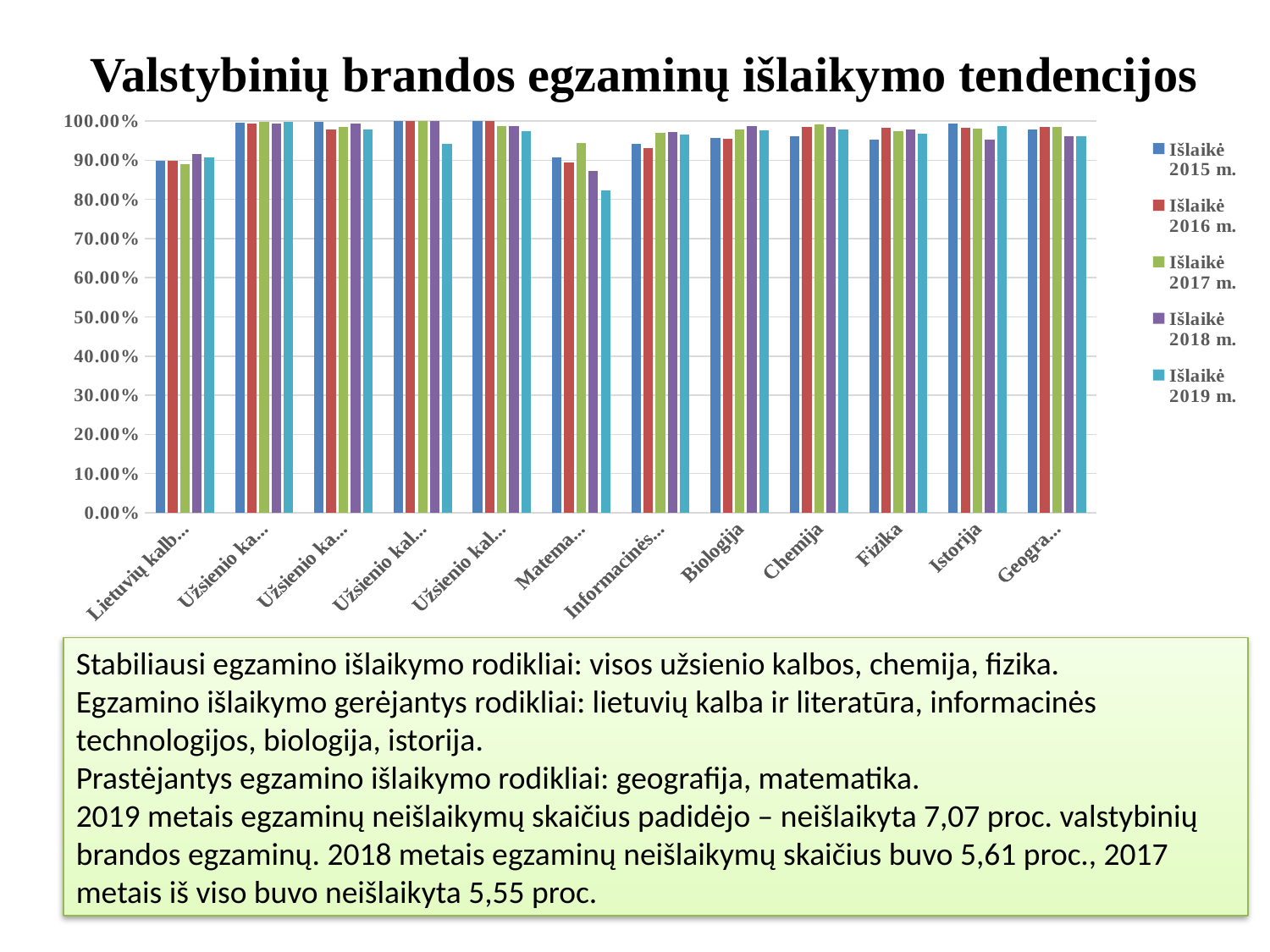
How many series does the legend list? 5 Is the value for Biologija in the Išlaikė 2015 m. series greater or less than 90.00%? greater Is the value for Fizika in the Išlaikė 2019 m. series greater or less than 90.00%? greater For Chemija, which is larger: the Išlaikė 2015 m. value or the Išlaikė 2017 m. value? Išlaikė 2017 m. What is the title of the chart? Valstybinių brandos egzaminų išlaikymo tendencijos For Istorija, which series has the lowest value? Išlaikė 2018 m. Is the value for Istorija in the Išlaikė 2018 m. series greater or less than 80.00%? greater For Istorija, which is larger: the Išlaikė 2015 m. value or the Išlaikė 2018 m. value? Išlaikė 2015 m. What kind of chart is shown on the slide? bar chart Which series is shown in red in the legend? Išlaikė 2016 m. For Fizika, which is larger: the Išlaikė 2015 m. value or the Išlaikė 2016 m. value? Išlaikė 2016 m. How many subject categories are shown along the x axis? 12